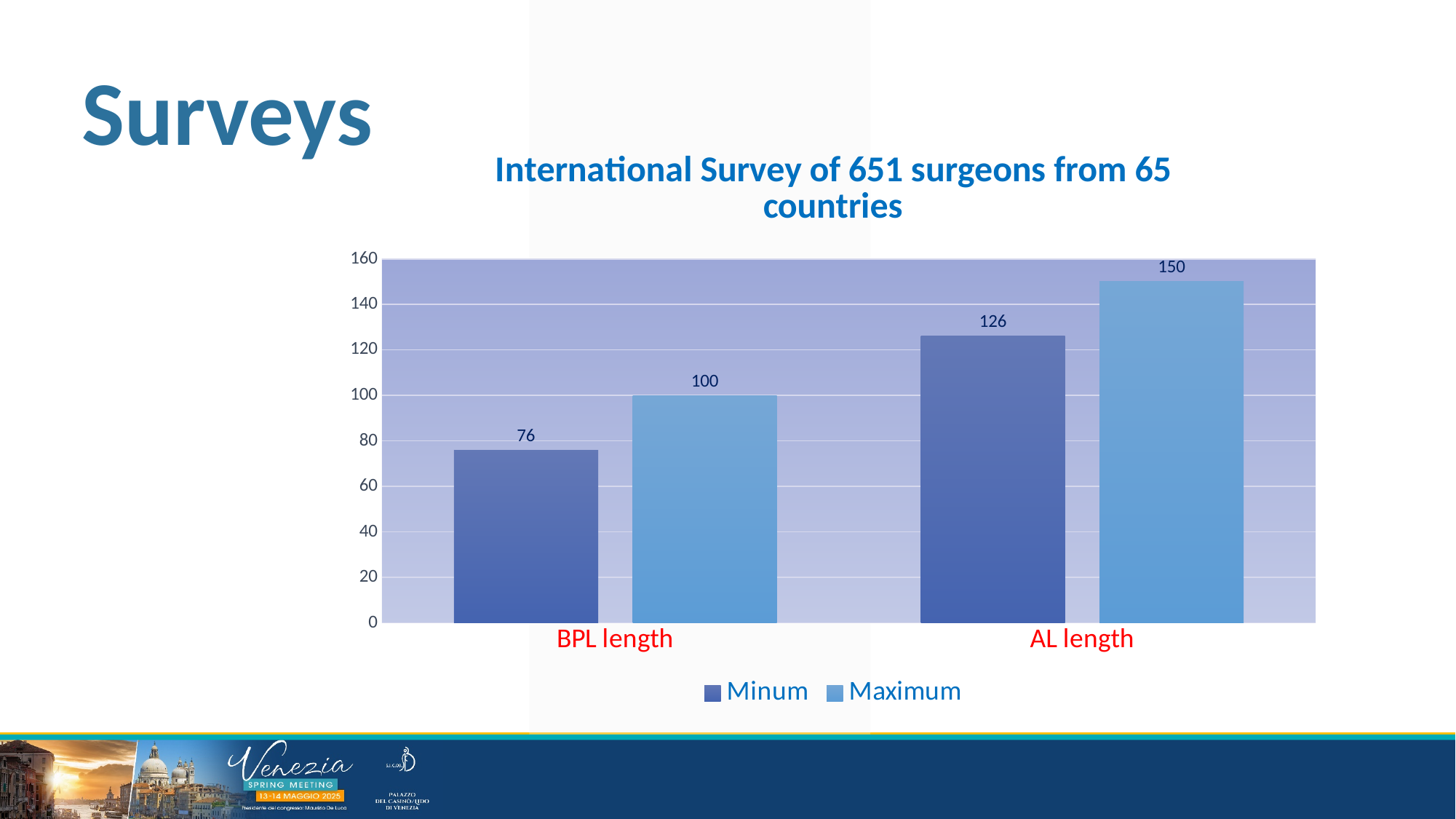
Which is larger: the Minum value for AL length or the Maximum value for BPL length? Minum value for AL length What is the Maximum value for AL length? 150 What is the difference between the Maximum values for AL length and BPL length? 50 What is the difference between the Maximum and Minum values for AL length? 24 What is the Maximum value for BPL length? 100 What is the Minum value for BPL length? 76 What is the Minum value for AL length? 126 What type of chart is shown on the slide? Bar chart Which category has the highest Maximum value? AL length Which category has the lowest Minum value? BPL length How many series does the legend list? 2 How many categories are shown on the x axis? 2